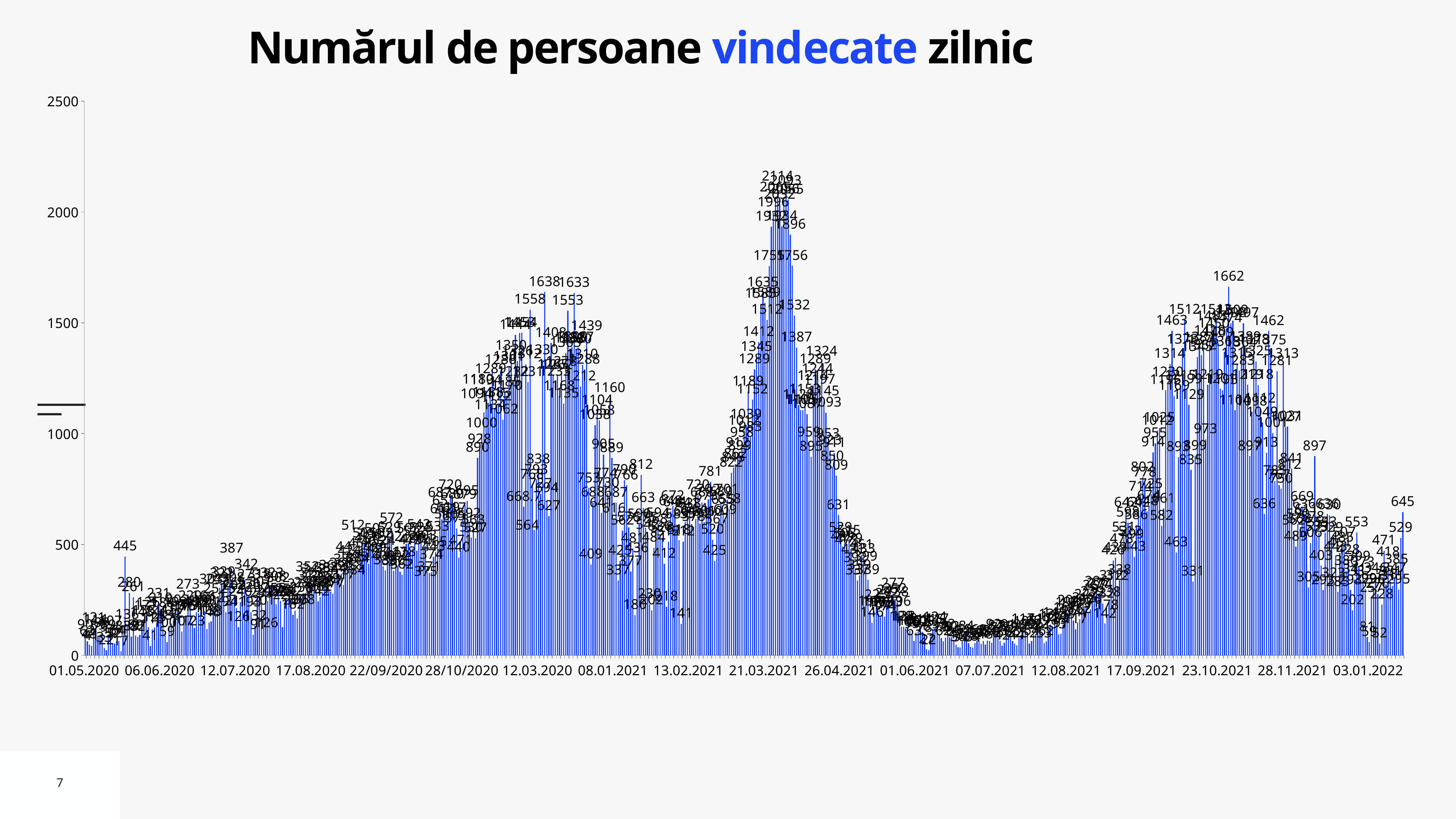
What is the title of the chart? Numărul de persoane vindecate zilnic Are the values around 07.07.2021 greater or less than 500? less Is the peak value around 21.03.2021 greater or less than 2000? greater What is the highest daily value labelled on the chart? 2114 What is the difference between the peak value 2114 and the peak value 1662? 452 What is the highest tick value shown on the vertical axis? 2500 Do the values rise or fall between 01.06.2021 and 07.07.2021? fall What is the value of the isolated spike just before the 06.06.2020 tick? 445 What kind of chart is shown on the slide? bar chart What is the value of the last bar on the chart, at the right end near 03.01.2022? 645 What is the value of the tallest bar in the wave between 17.09.2021 and 28.11.2021? 1662 Which peak is higher: the one around 21.03.2021 or the one around 23.10.2021? the one around 21.03.2021